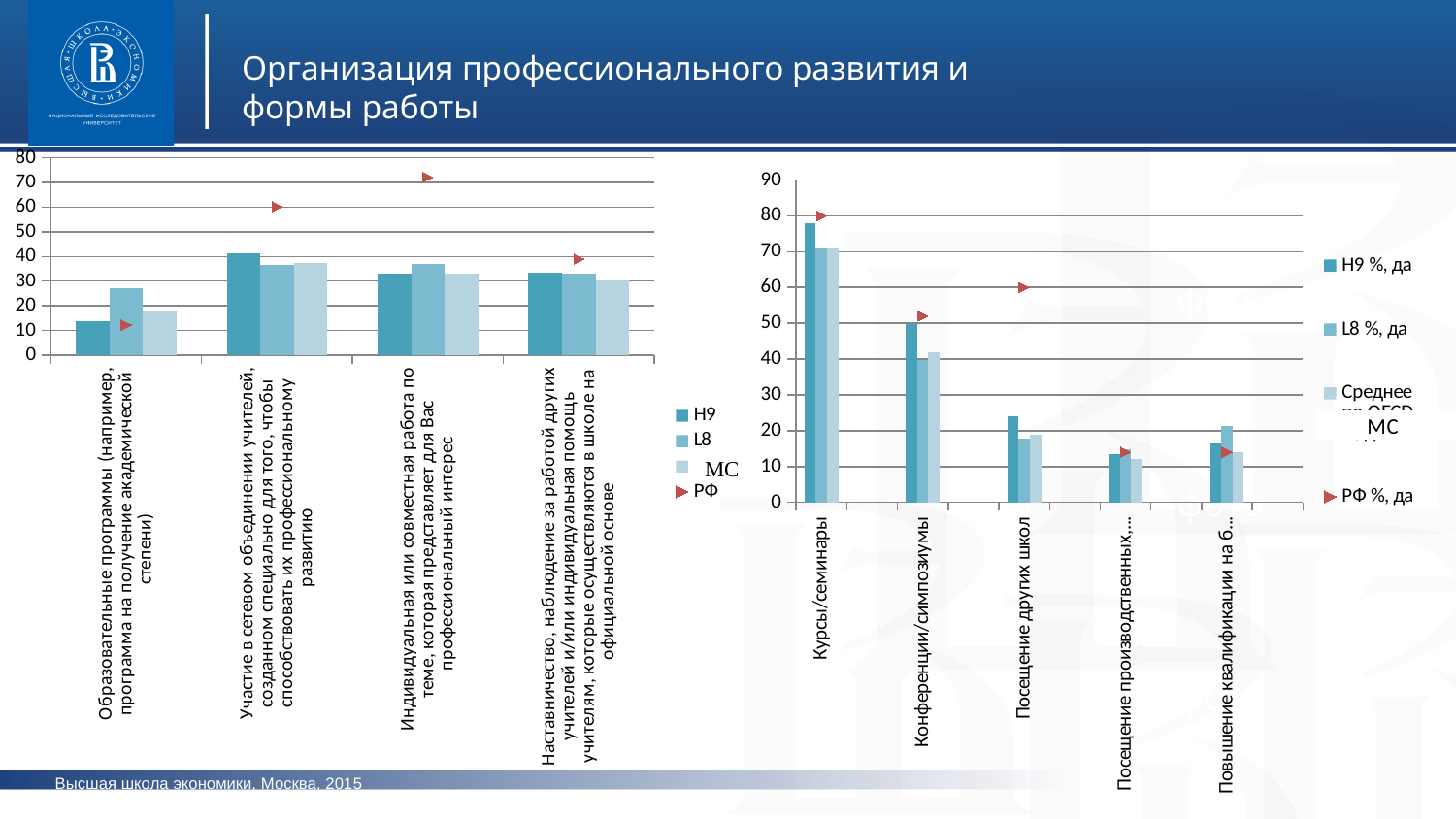
In the chart on the left side of the slide, how many series does the legend list? 4 In the chart on the right side of the slide, is the РФ marker for Посещение других школ greater or less than 50? greater In the chart on the right side of the slide, which category has the highest H9 bar? Курсы/семинары In the chart on the left side of the slide, is the H9 value for Образовательные программы greater or less than 20? less In the chart on the right side of the slide, is the H9 value for Курсы/семинары greater or less than 70? greater What kind of chart is the chart on the left side of the slide? bar chart In the chart on the left side of the slide, which category has the lowest H9 bar? Образовательные программы In the chart on the right side of the slide, which category has the highest РФ marker? Курсы/семинары In the chart on the left side of the slide, for Образовательные программы, which is larger: the H9 bar or the L8 bar? L8 In the chart on the right side of the slide, how many categories are shown on the x axis? 5